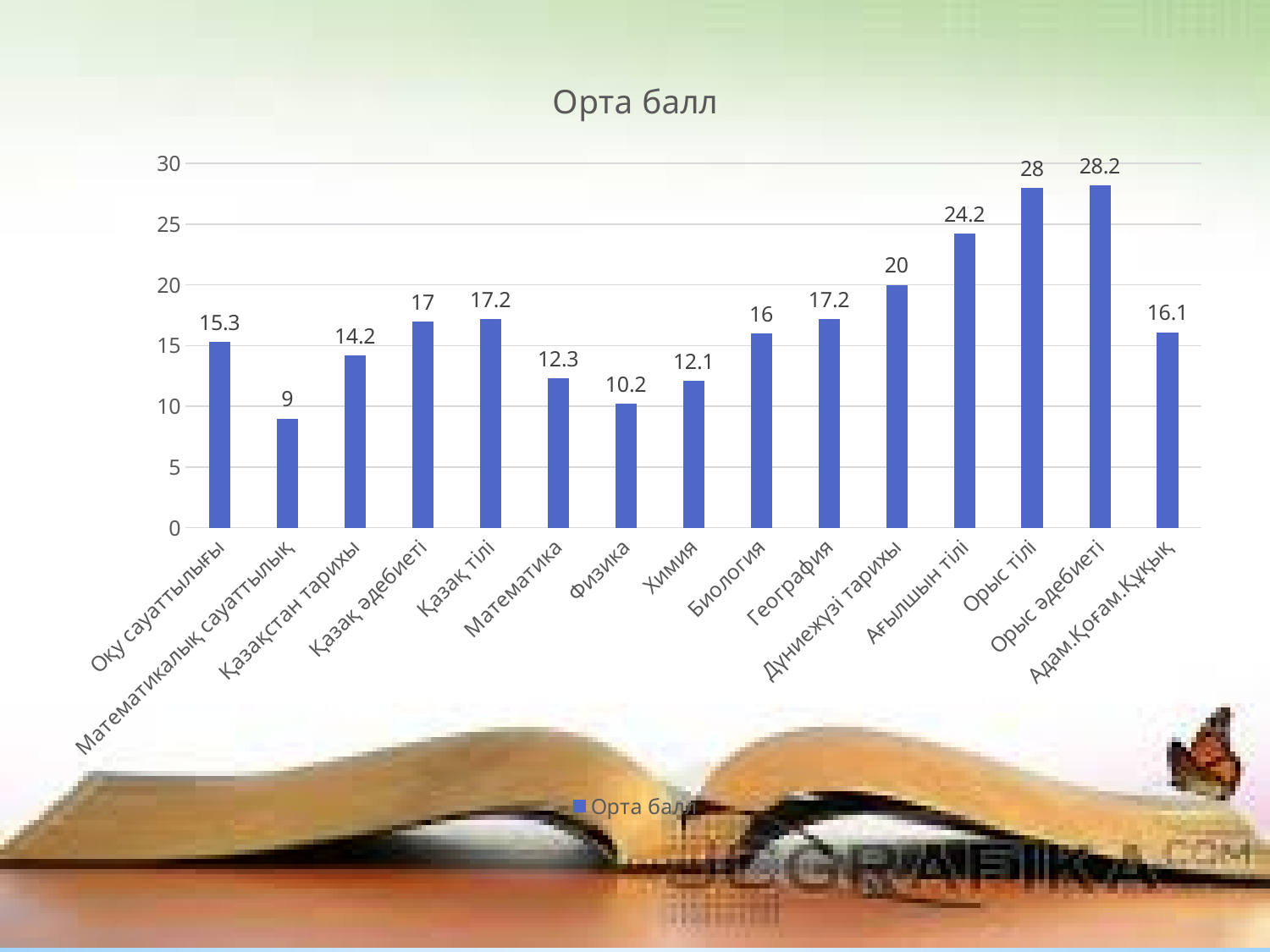
Is the value for Қазақстан тарихы greater or less than 15? less What is the value for Ағылшын тілі in the Орта балл chart? 24.2 Which category has the lowest value in the chart? Математикалық сауаттылық Which is larger, the value for Биология or the value for Химия? Биология What is the difference between the values for Орыс тілі and Математикалық сауаттылық? 19 How many categories are shown on the x axis of the chart? 15 What is the title of the chart? Орта балл What is the difference between the values for Қазақ тілі and Математика? 4.9 Which category has the highest value in the chart? Орыс әдебиеті What kind of chart is shown on the slide? bar chart What is the value for Дүниежүзі тарихы? 20 What is the value for Физика in the Орта балл chart? 10.2